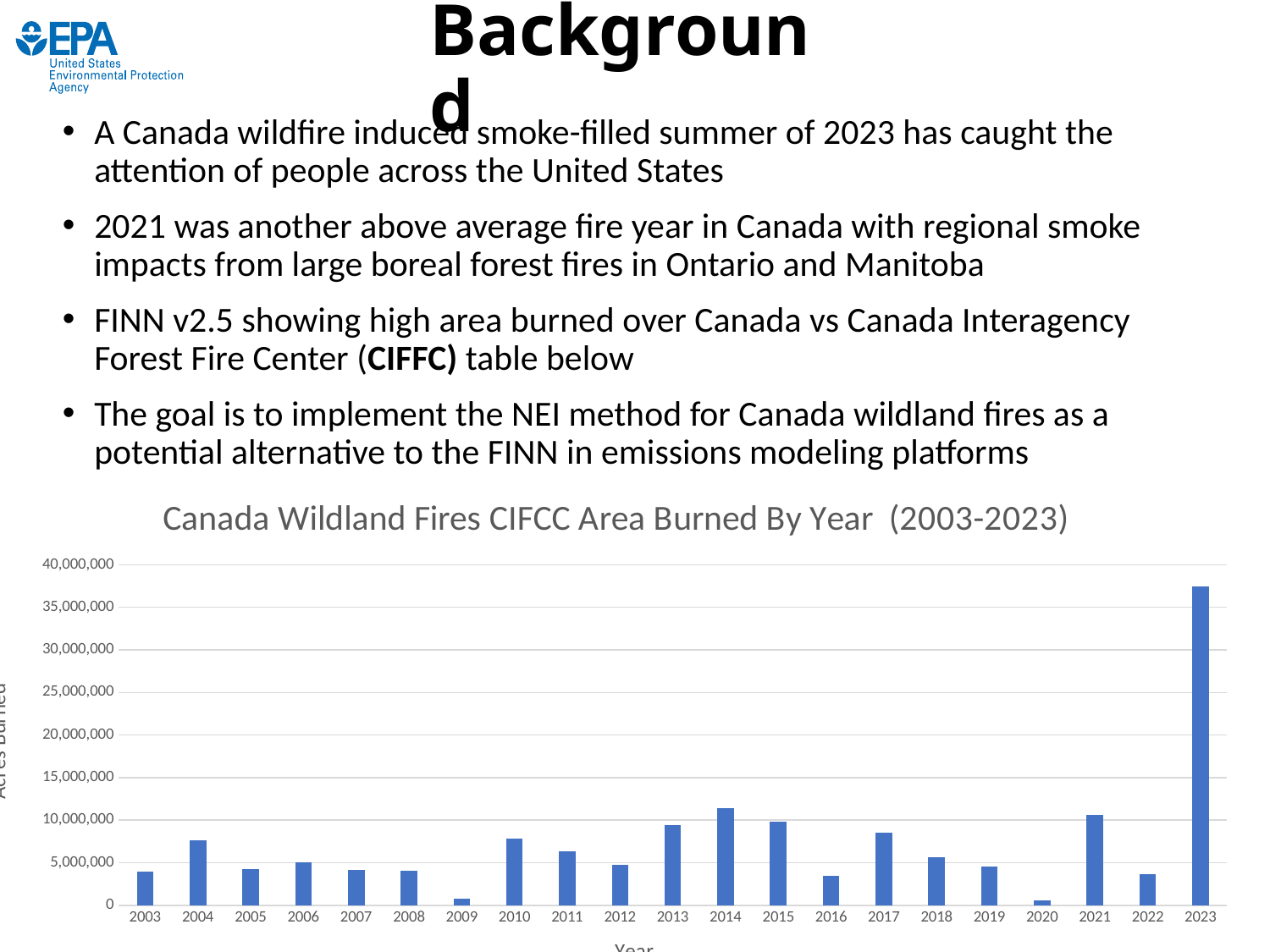
Is the value for 2009 greater or less than 5,000,000? less Is the value for 2017 greater or less than 5,000,000? greater Which year has the larger area burned, 2013 or 2014? 2014 What is the title of the chart? Canada Wildland Fires CIFCC Area Burned By Year (2003-2023) Which year has the larger area burned, 2021 or 2022? 2021 What type of chart is shown on the slide? bar chart Which year has the larger area burned, 2003 or 2004? 2004 How many years are plotted on the x axis of the chart? 21 Which year has the highest area burned in the chart? 2023 Is the value for 2023 greater or less than 35,000,000? greater